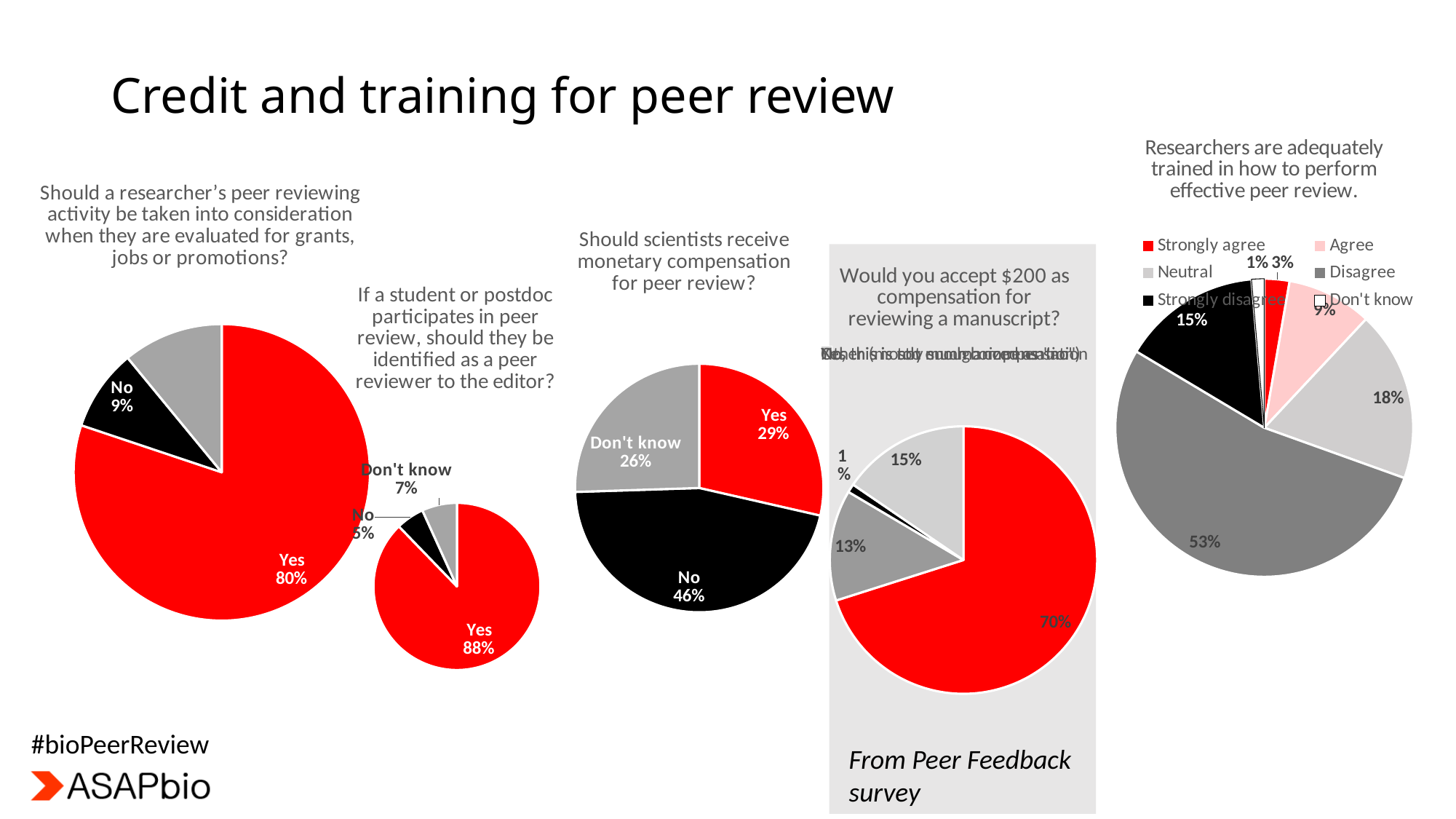
In the chart 'If a student or postdoc participates in peer review, should they be identified as a peer reviewer to the editor?', what is the difference between the Don't know and No shares? 2% In the chart 'Should scientists receive monetary compensation for peer review?', which response has the largest share? No In the chart 'Researchers are adequately trained in how to perform effective peer review', what percentage chose Disagree? 53% How many slices does the pie chart 'Would you accept $200 as compensation for reviewing a manuscript?' have? 4 How many entries does the legend of the chart 'Researchers are adequately trained in how to perform effective peer review' list? 6 In the chart 'If a student or postdoc participates in peer review, should they be identified as a peer reviewer to the editor?', what percentage answered Yes? 88% What type of chart is used for 'Should scientists receive monetary compensation for peer review?' Pie chart In the chart 'Would you accept $200 as compensation for reviewing a manuscript?', what is the value of the largest slice? 70% In the chart 'Should a researcher's peer reviewing activity be taken into consideration when they are evaluated for grants, jobs or promotions?', what percentage answered Yes? 80% In the chart 'Should a researcher's peer reviewing activity be taken into consideration when they are evaluated for grants, jobs or promotions?', what percentage answered No? 9% In the chart 'Should scientists receive monetary compensation for peer review?', how much larger is the No share than the Yes share? 17% In the chart 'Should scientists receive monetary compensation for peer review?', what percentage answered Don't know? 26%